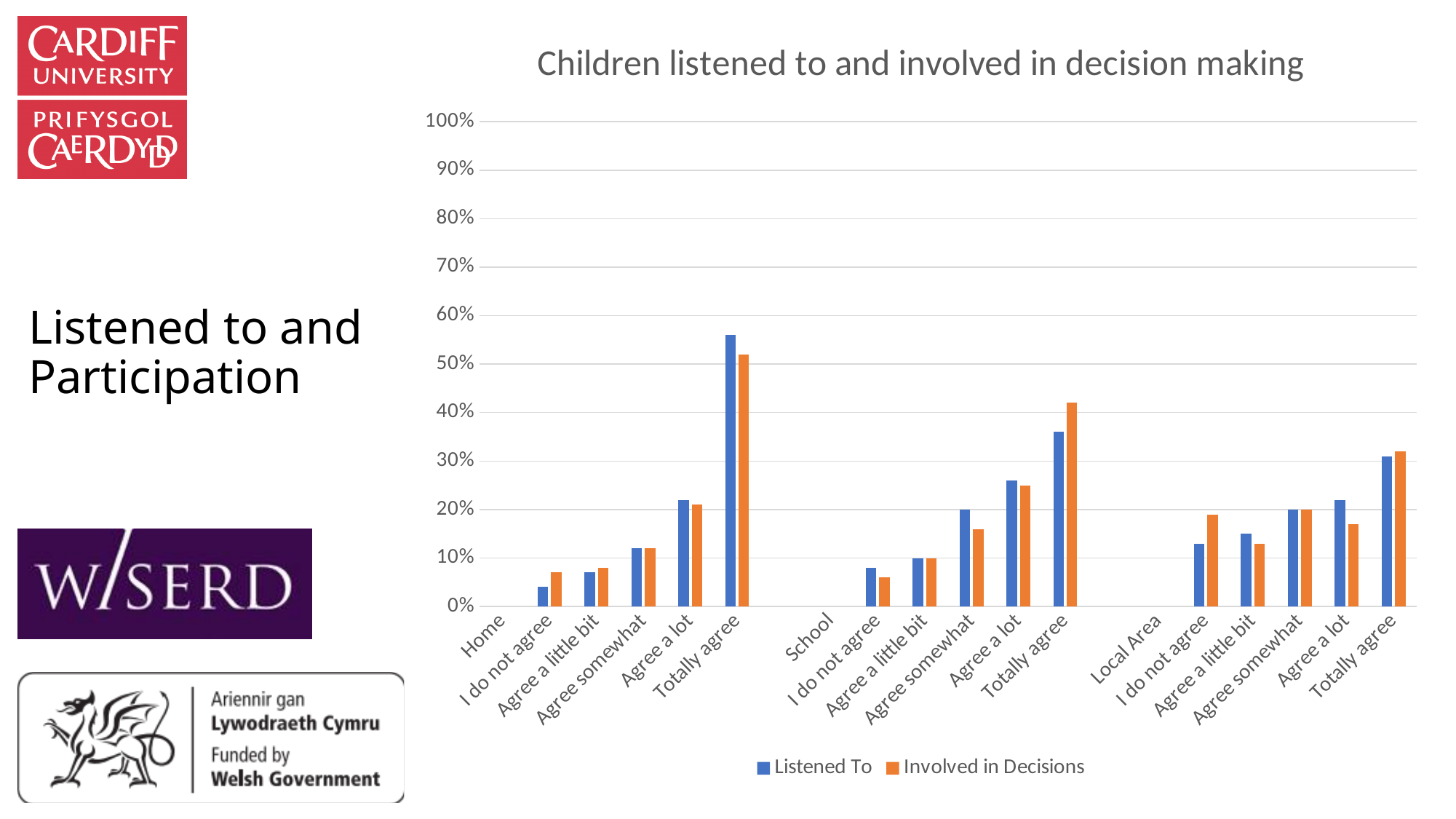
What are the two series named in the legend? Listened To and Involved in Decisions Which response category has the highest Listened To value across the whole chart? Totally agree (Home) What kind of chart is shown on the slide? bar chart Is the Listened To value for I do not agree under Home greater or less than 10%? less How many series does the legend list? 2 Within the Home group, do the Listened To values rise or fall from I do not agree to Totally agree? rise What is the title of the chart? Children listened to and involved in decision making For Totally agree under School, which series has the larger value, Listened To or Involved in Decisions? Involved in Decisions Is the Listened To value for Totally agree under Home greater or less than 50%? greater How many settings (groups of response categories) are shown on the x axis? 3 Is the Involved in Decisions value for Totally agree under School greater or less than 40%? greater For I do not agree under Local Area, which series has the larger value, Listened To or Involved in Decisions? Involved in Decisions